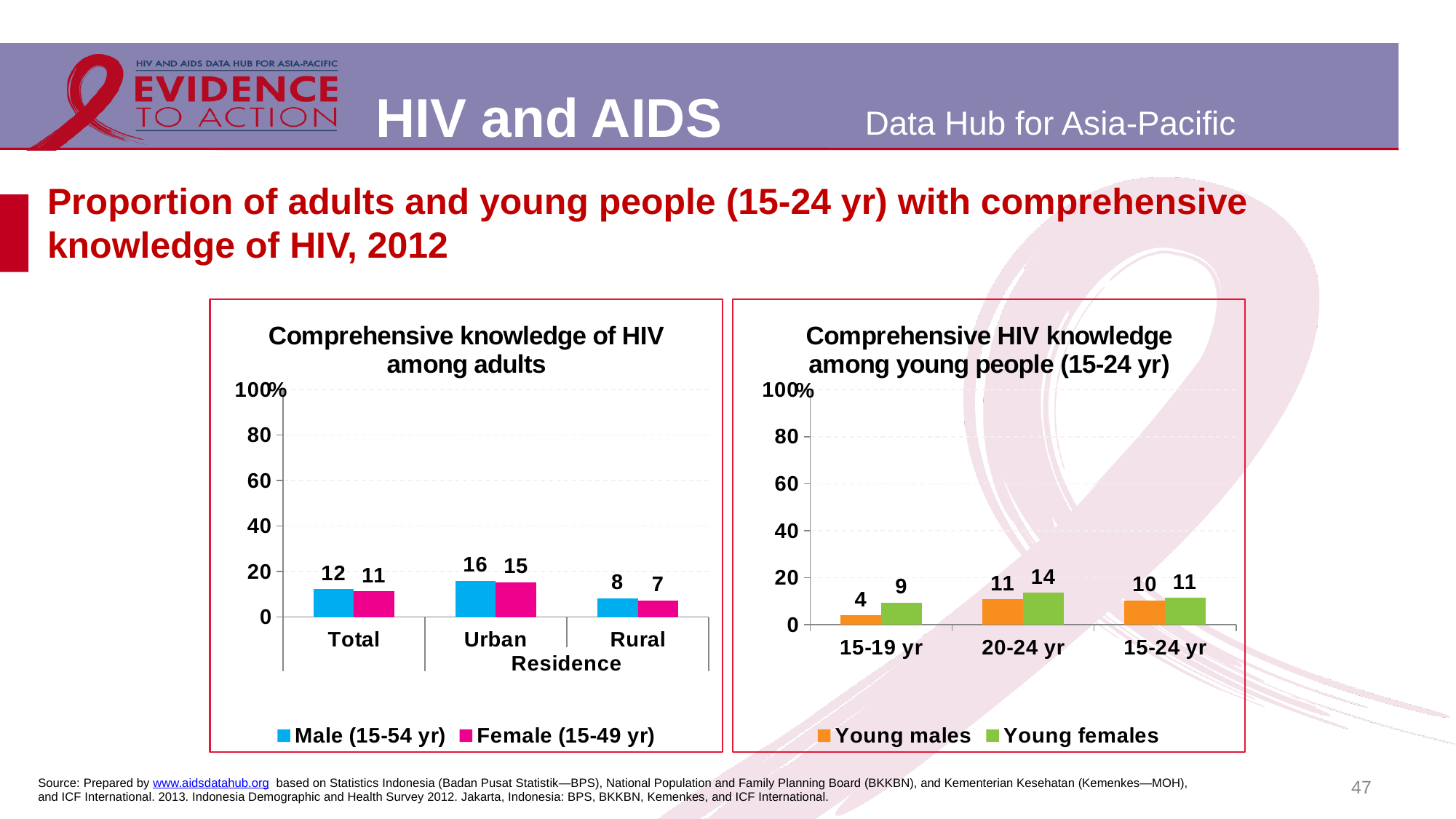
What type of chart is the 'Comprehensive knowledge of HIV among adults' chart? Bar chart In the 'Comprehensive knowledge of HIV among adults' chart, how many series does the legend list? 2 In the 'Comprehensive HIV knowledge among young people (15-24 yr)' chart, what is the value for Young males in the 15-19 yr group? 4 In the 'Comprehensive knowledge of HIV among adults' chart, which residence category has the highest value for Male (15-54 yr)? Urban In the 'Comprehensive HIV knowledge among young people (15-24 yr)' chart, how many age group categories are shown on the x axis? 3 In the 'Comprehensive HIV knowledge among young people (15-24 yr)' chart, what is the difference between Young females and Young males in the 20-24 yr group? 3 In the 'Comprehensive knowledge of HIV among adults' chart, what is the difference between the Male and Female values for Total? 1 In the 'Comprehensive HIV knowledge among young people (15-24 yr)' chart, which is larger in the 15-19 yr group: Young males or Young females? Young females In the 'Comprehensive HIV knowledge among young people (15-24 yr)' chart, which age group has the lowest value for Young males? 15-19 yr In the 'Comprehensive knowledge of HIV among adults' chart, what is the value for Male (15-54 yr) in Urban? 16 In the 'Comprehensive HIV knowledge among young people (15-24 yr)' chart, what is the value for Young females in the 20-24 yr group? 14 In the 'Comprehensive knowledge of HIV among adults' chart, what is the value for Female (15-49 yr) in Rural? 7